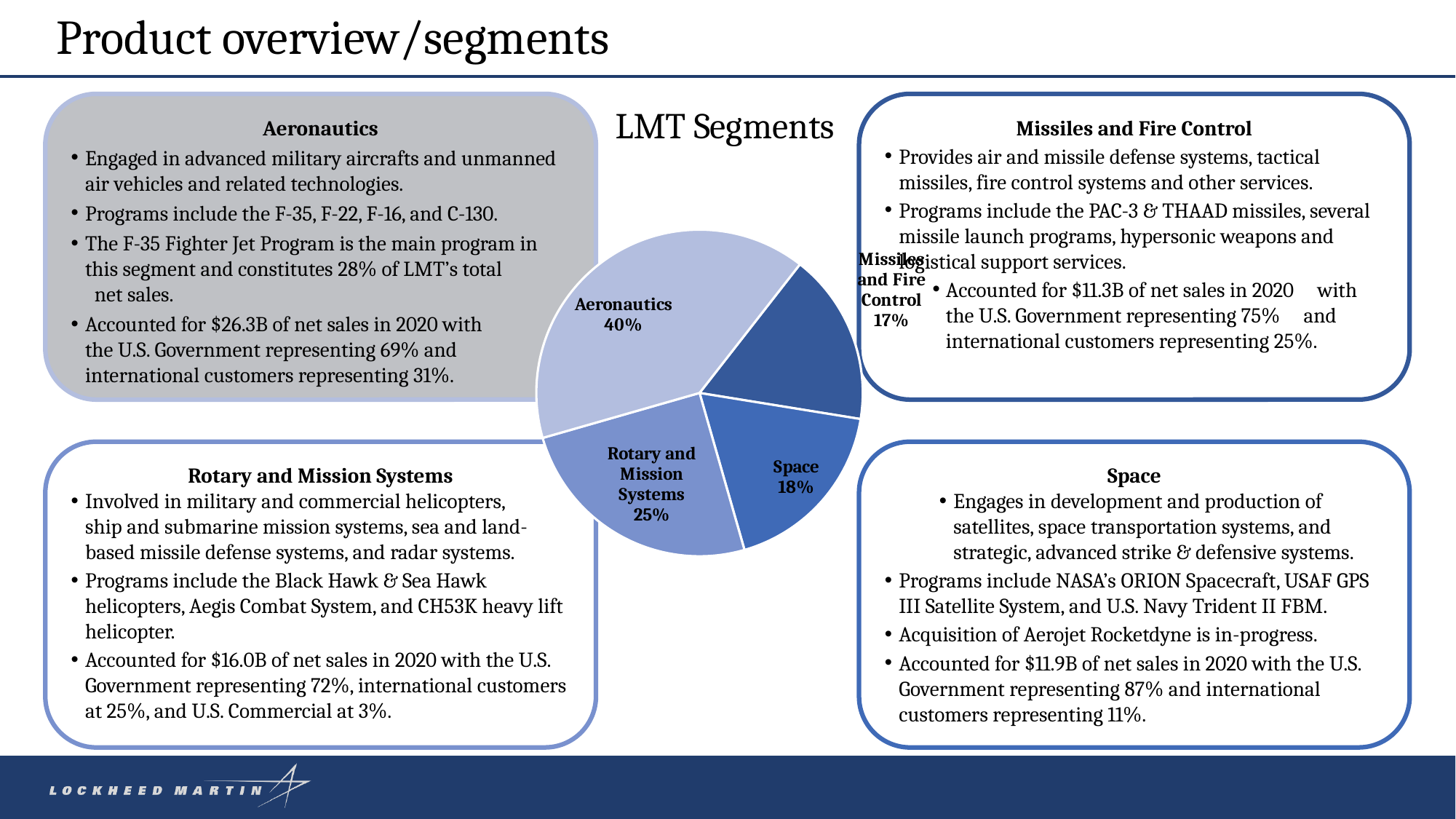
Which segment has the smallest slice of the pie? Missiles and Fire Control What share of the pie does Rotary and Mission Systems represent? 25% What share of the pie does Missiles and Fire Control represent? 17% What is the difference in percentage points between Space and Missiles and Fire Control? 1 What type of chart is shown under the title 'LMT Segments'? pie chart How many segments are shown in the pie chart? 4 What is the difference in percentage points between Aeronautics and Rotary and Mission Systems? 15 What is the title of the pie chart? LMT Segments Which is larger, the Rotary and Mission Systems slice or the Space slice? Rotary and Mission Systems What share of the pie does Aeronautics represent? 40% Which segment has the largest slice of the pie? Aeronautics What share of the pie does Space represent? 18%